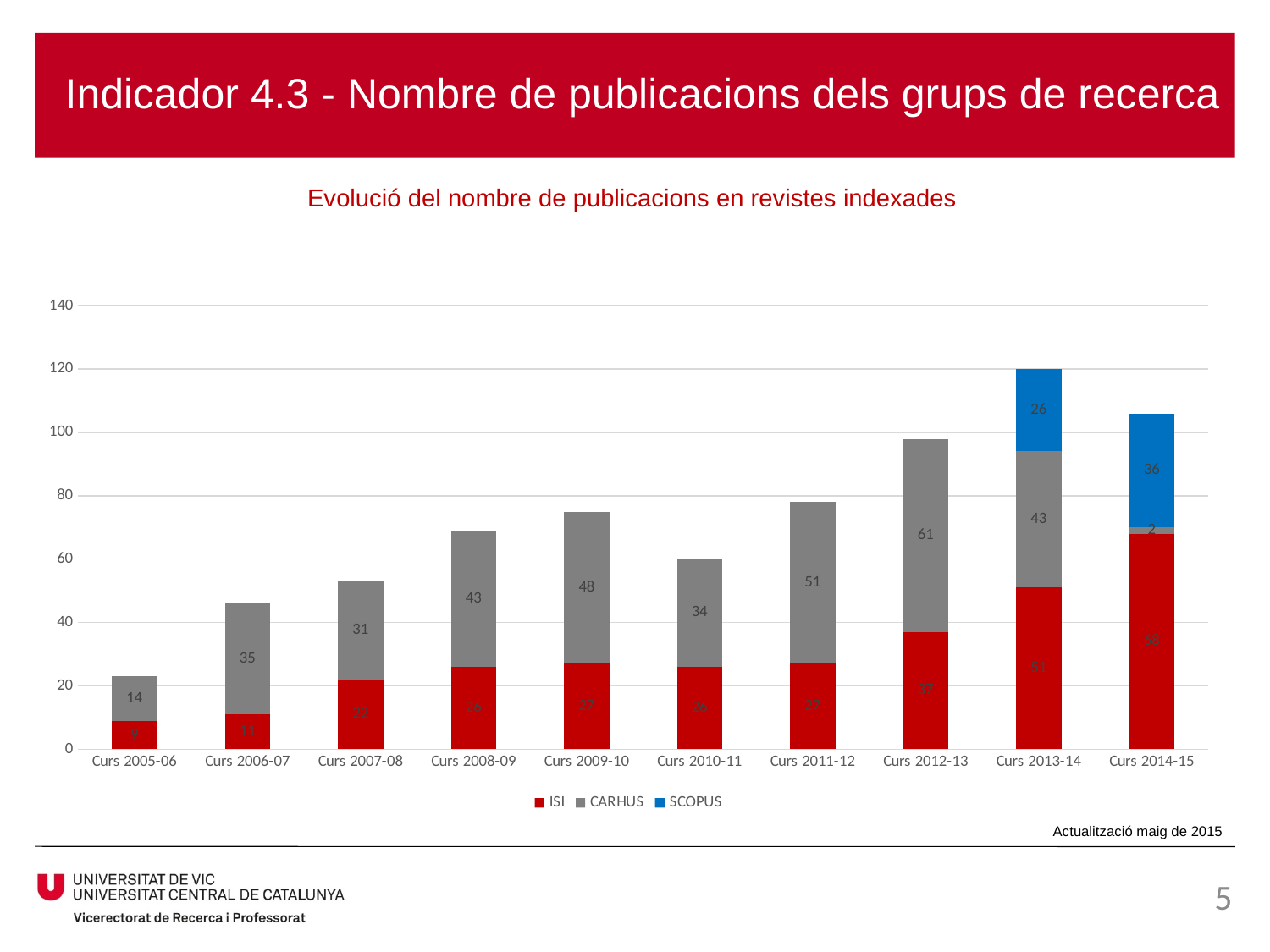
What kind of chart is shown on the slide? Stacked bar chart In which academic year is the CARHUS value lowest? Curs 2014-15 What is the CARHUS value for Curs 2012-13? 61 How many series does the legend list? 3 How many academic years (Curs) are shown on the x axis? 10 Is the total height of the bar for Curs 2012-13 greater or less than 80? greater What is the SCOPUS value for Curs 2014-15? 36 What is the SCOPUS value for Curs 2013-14? 26 Which year has the larger SCOPUS value, Curs 2013-14 or Curs 2014-15? Curs 2014-15 In which academic year is the CARHUS value highest? Curs 2012-13 What is the difference between the CARHUS values for Curs 2009-10 and Curs 2010-11? 14 Which colour represents the SCOPUS series in the legend? Blue